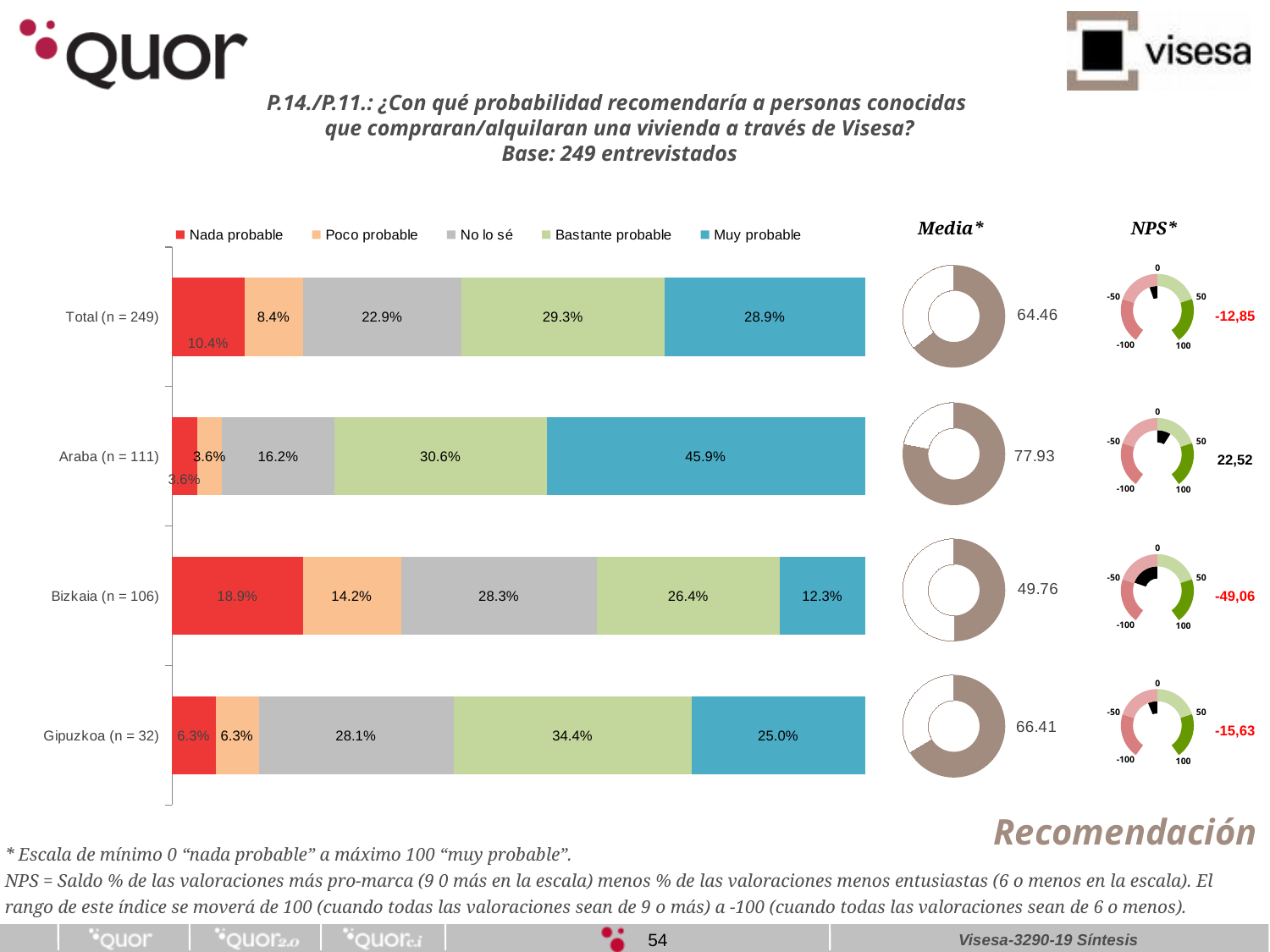
What kind of chart is the main chart on the left of the slide? Stacked bar chart In the stacked bar chart, which category has the highest "Nada probable" value? Bizkaia (n = 106) In the Media* column, what is the value shown for Bizkaia (n = 106)? 49.76 In the stacked bar chart, which category has the lowest "Muy probable" value? Bizkaia (n = 106) In the stacked bar chart, what is the value of "No lo sé" for Bizkaia (n = 106)? 28.3% In the NPS* column, what is the value shown for Araba (n = 111)? 22,52 How many categories does the stacked bar chart show? 4 In the stacked bar chart, what is the value of "Bastante probable" for Gipuzkoa (n = 32)? 34.4% How many series does the legend of the stacked bar chart list? 5 In the stacked bar chart, what is the difference between the "Muy probable" values for Araba (n = 111) and Total (n = 249)? 17.0% In the stacked bar chart, which is larger for Total (n = 249): "Bastante probable" or "Muy probable"? Bastante probable In the stacked bar chart, what is the value of "Muy probable" for Araba (n = 111)? 45.9%